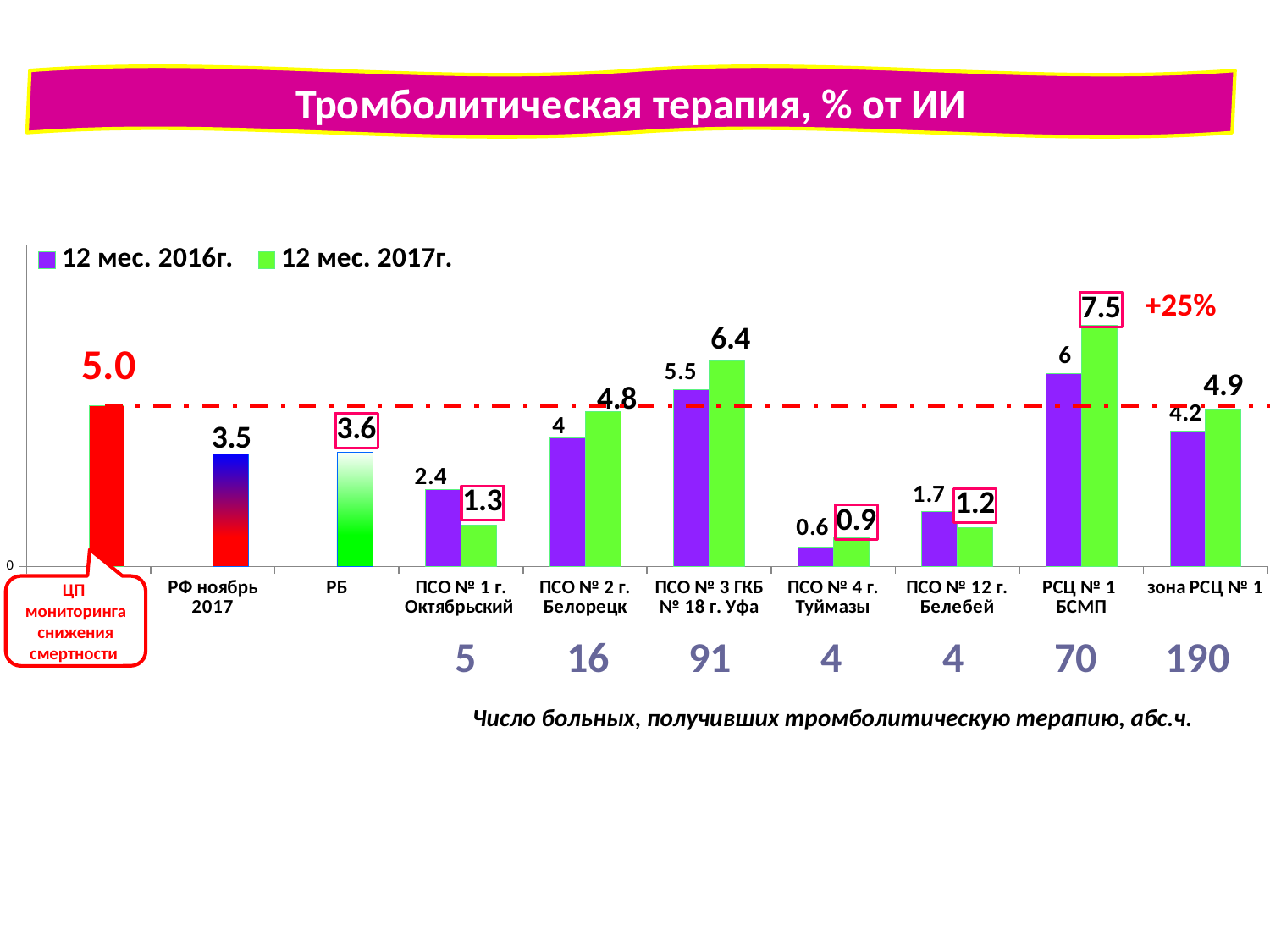
Which is larger for ПСО № 12 г. Белебей: the 12 мес. 2016г. value or the 12 мес. 2017г. value? 12 мес. 2016г. What is the value for ПСО № 1 г. Октябрьский in the 12 мес. 2016г. series? 2.4 What is the value for зона РСЦ № 1 in the 12 мес. 2016г. series? 4.2 What is the value of the red target bar labelled ЦП мониторинга снижения смертности? 5.0 What is the difference between the 12 мес. 2017г. and 12 мес. 2016г. values for РСЦ № 1 БСМП? 1.5 Which category has the lowest value in the 12 мес. 2016г. series? ПСО № 4 г. Туймазы Which category has the highest value in the 12 мес. 2017г. series? РСЦ № 1 БСМП What is the title of the chart? Тромболитическая терапия, % от ИИ What is the value for ПСО № 3 ГКБ № 18 г. Уфа in the 12 мес. 2017г. series? 6.4 How many series does the legend list? 2 What is the value shown for РБ? 3.6 What kind of chart is shown on the slide? Bar chart